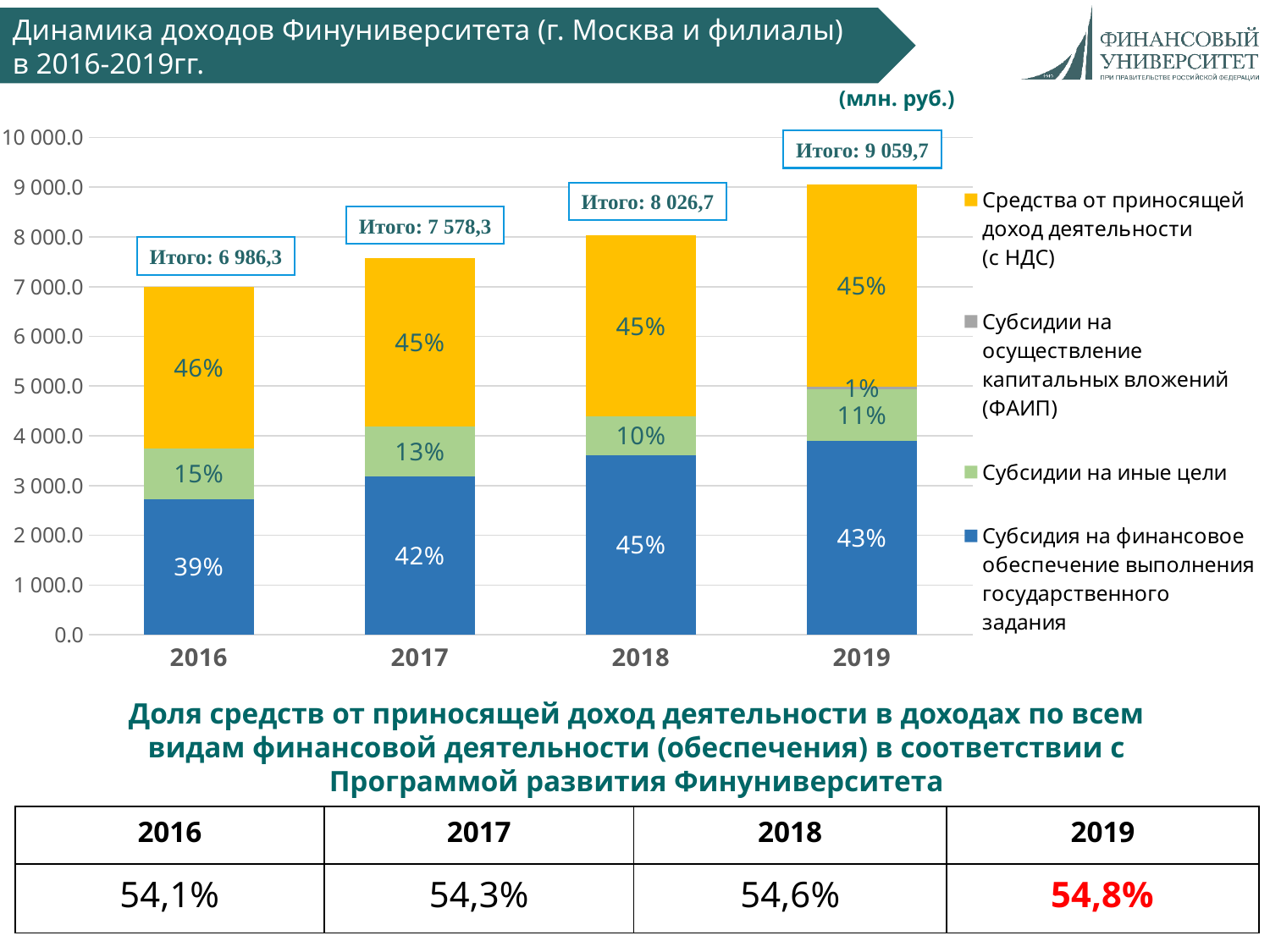
What kind of chart is shown on the slide? stacked bar chart How many series does the chart legend list? 4 What percentage does the 'Субсидии на осуществление капитальных вложений (ФАИП)' segment show for 2019? 1% Do the total incomes rise or fall from 2016 to 2019? rise What percentage does the 'Субсидии на иные цели' segment show for 2016? 15% What is the total (Итого) income shown for 2019? 9 059,7 What is the total (Итого) income shown for 2016? 6 986,3 How many years are shown on the x axis of the chart? 4 Which year has the highest total income? 2019 By how much does the total income for 2019 exceed the total for 2016? 2 073,4 Which year has the lowest total income? 2016 What percentage does the 'Субсидия на финансовое обеспечение выполнения государственного задания' segment show for 2017? 42%